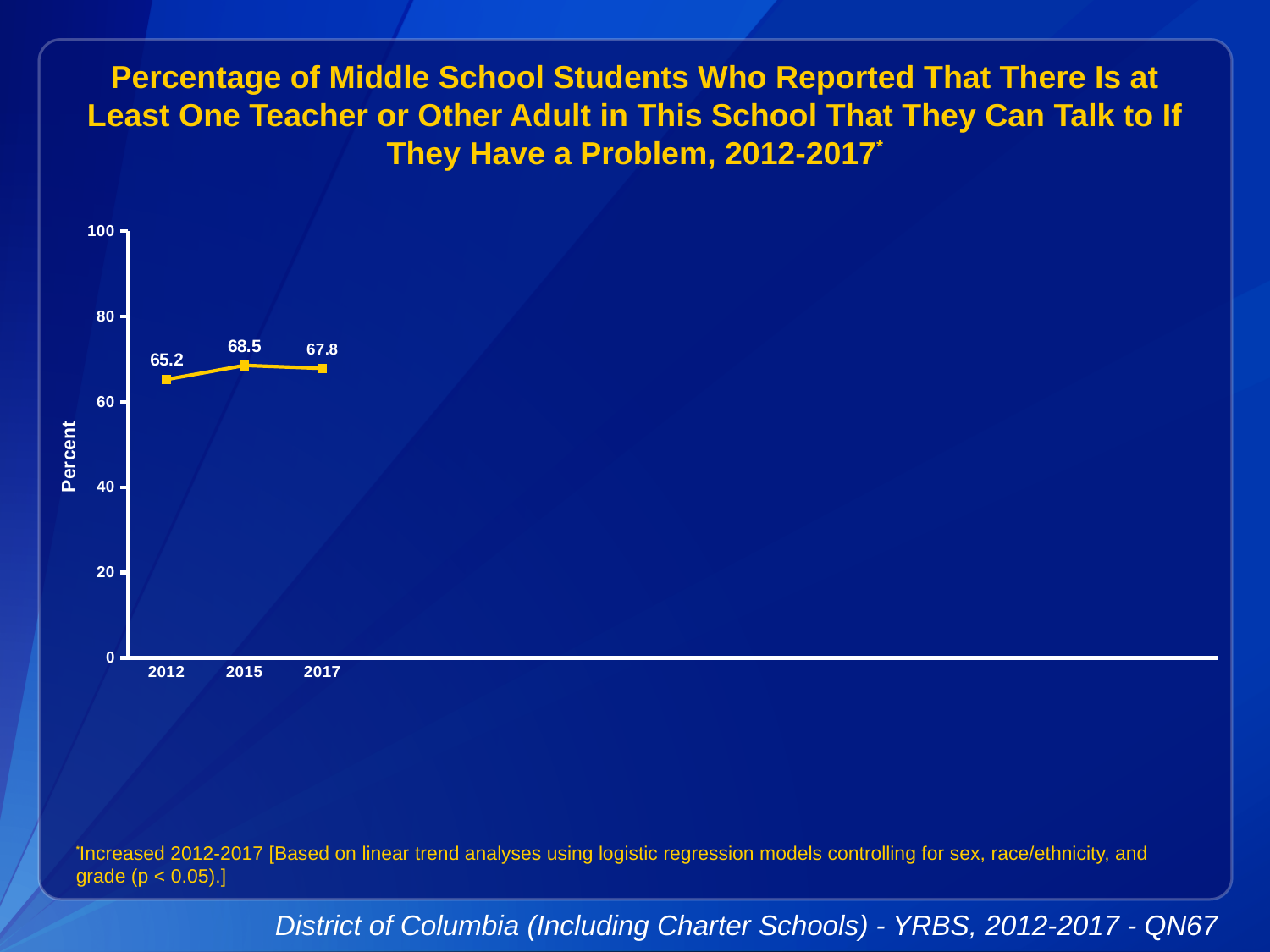
Which year has the lowest value on the chart? 2012 What is the difference between the 2017 value and the 2012 value? 2.6 What is the value plotted for 2017? 67.8 What kind of chart is shown on the slide? Line chart What is the value plotted for 2015? 68.5 Which year has the highest value on the chart? 2015 What is the label on the y axis of the chart? Percent Which year has a larger value, 2012 or 2017? 2017 Is the value for 2015 greater or less than 60? greater What percentage of middle school students reported having at least one teacher or other adult to talk to in 2012? 65.2 What is the difference between the 2015 value and the 2012 value? 3.3 How many years are plotted on the chart? 3